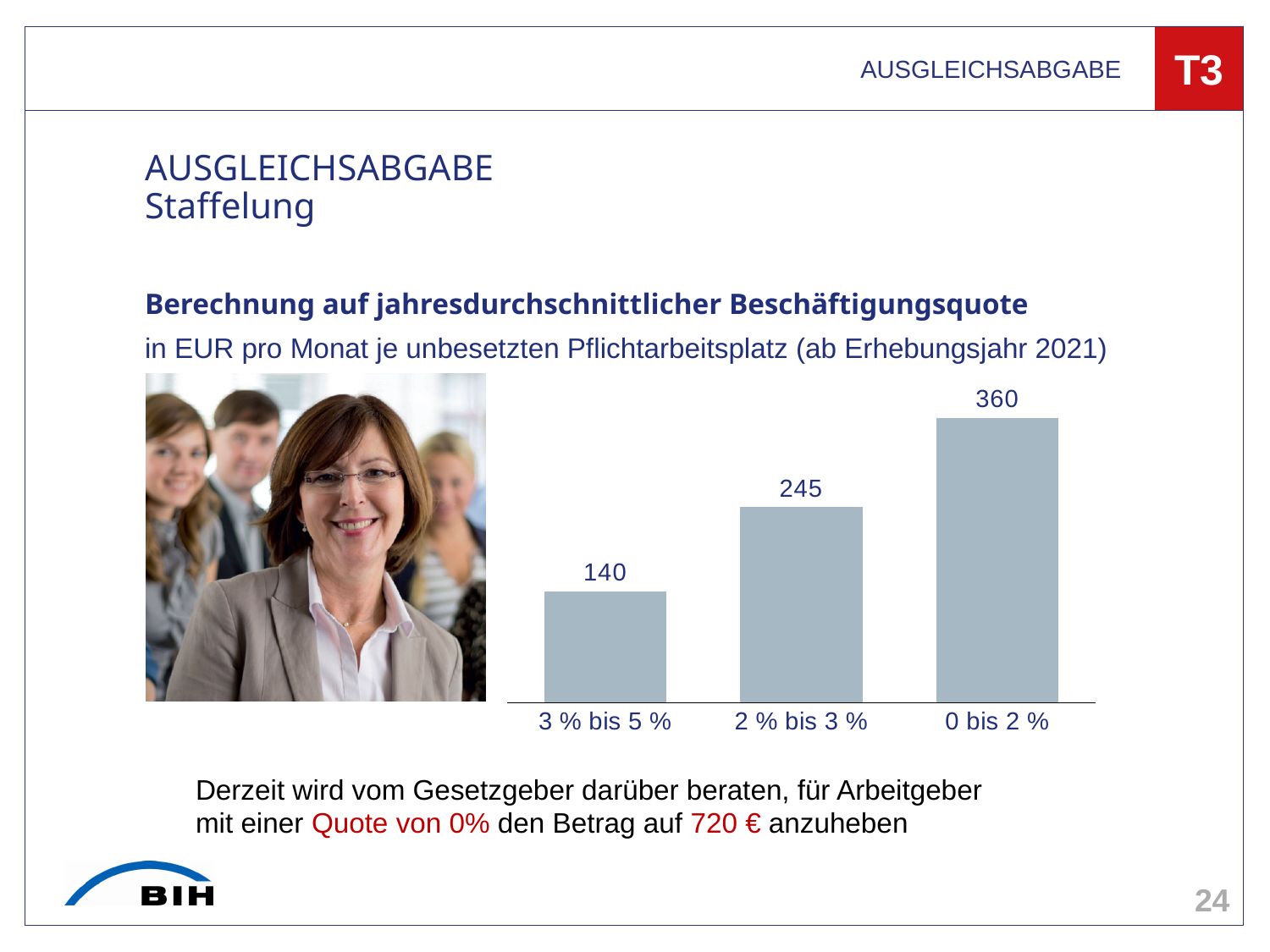
What is the value for the category "3 % bis 5 %"? 140 How many categories are shown in the chart? 3 Do the values rise or fall from left to right along the x axis? rise What is the difference between the values for "2 % bis 3 %" and "3 % bis 5 %"? 105 What is the value for the category "0 bis 2 %"? 360 What colour are the bars in the chart? grey-blue What is the difference between the values for "0 bis 2 %" and "3 % bis 5 %"? 220 Which is larger, the value for "2 % bis 3 %" or the value for "0 bis 2 %"? 0 bis 2 % Which category has the highest value? 0 bis 2 % What kind of chart is shown on the slide? bar chart What is the value for the category "2 % bis 3 %"? 245 Which category has the lowest value? 3 % bis 5 %